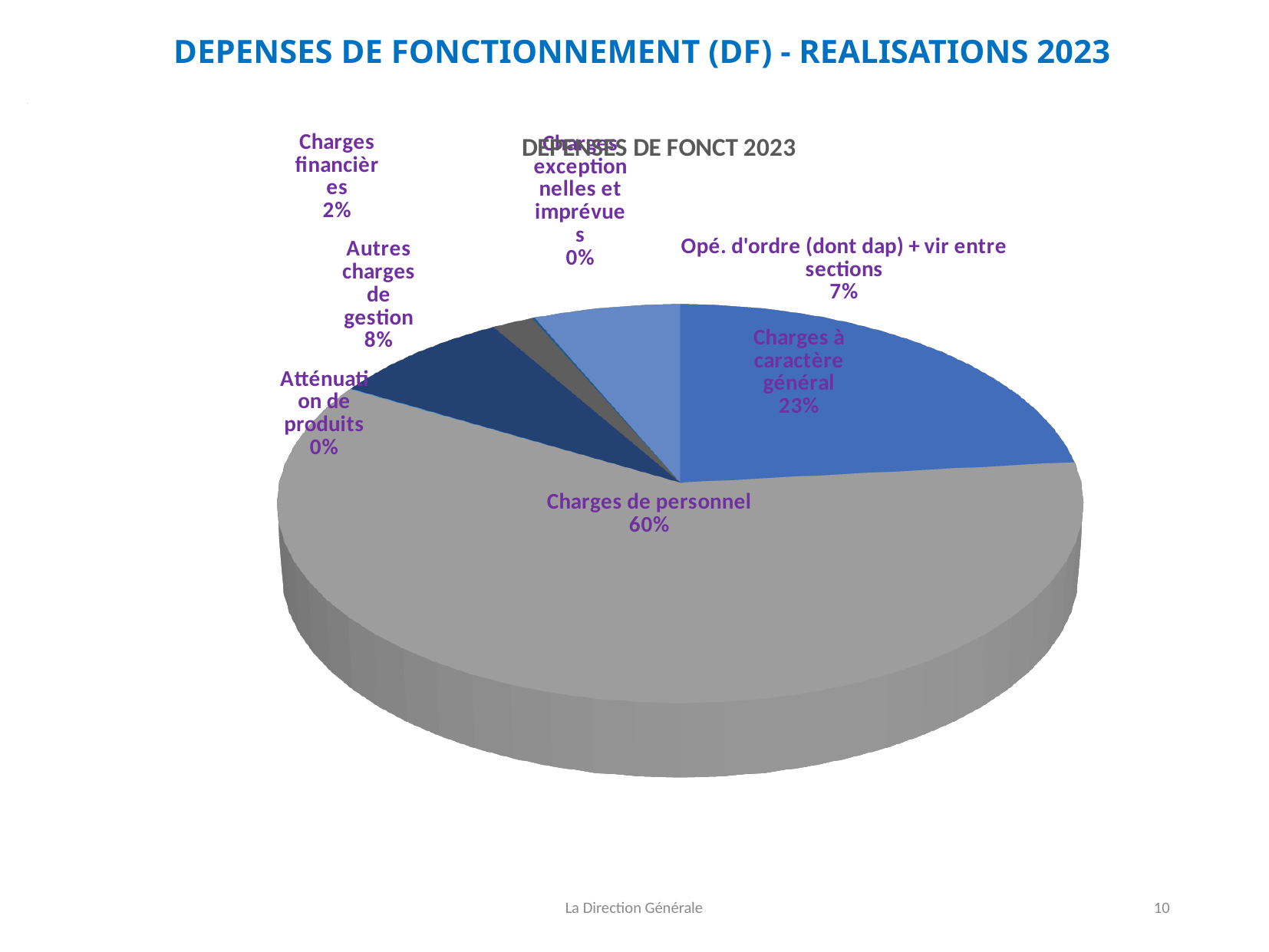
What percentage is shown for Autres charges de gestion? 8% How many categories are shown in the pie chart? 7 What is the difference in percentage points between Charges de personnel and Charges à caractère général? 37 What percentage is shown for Opé. d'ordre (dont dap) + vir entre sections? 7% Which is larger, Autres charges de gestion or Opé. d'ordre (dont dap) + vir entre sections? Autres charges de gestion What percentage is shown for Atténuation de produits? 0% What percentage is shown for Charges financières? 2% What share of the pie is Charges à caractère général? 23% What share of the pie is Charges de personnel? 60% Which category has the largest share of the pie? Charges de personnel What kind of chart is shown on the slide? Pie chart What is the chart's title? DEPENSES DE FONCT 2023